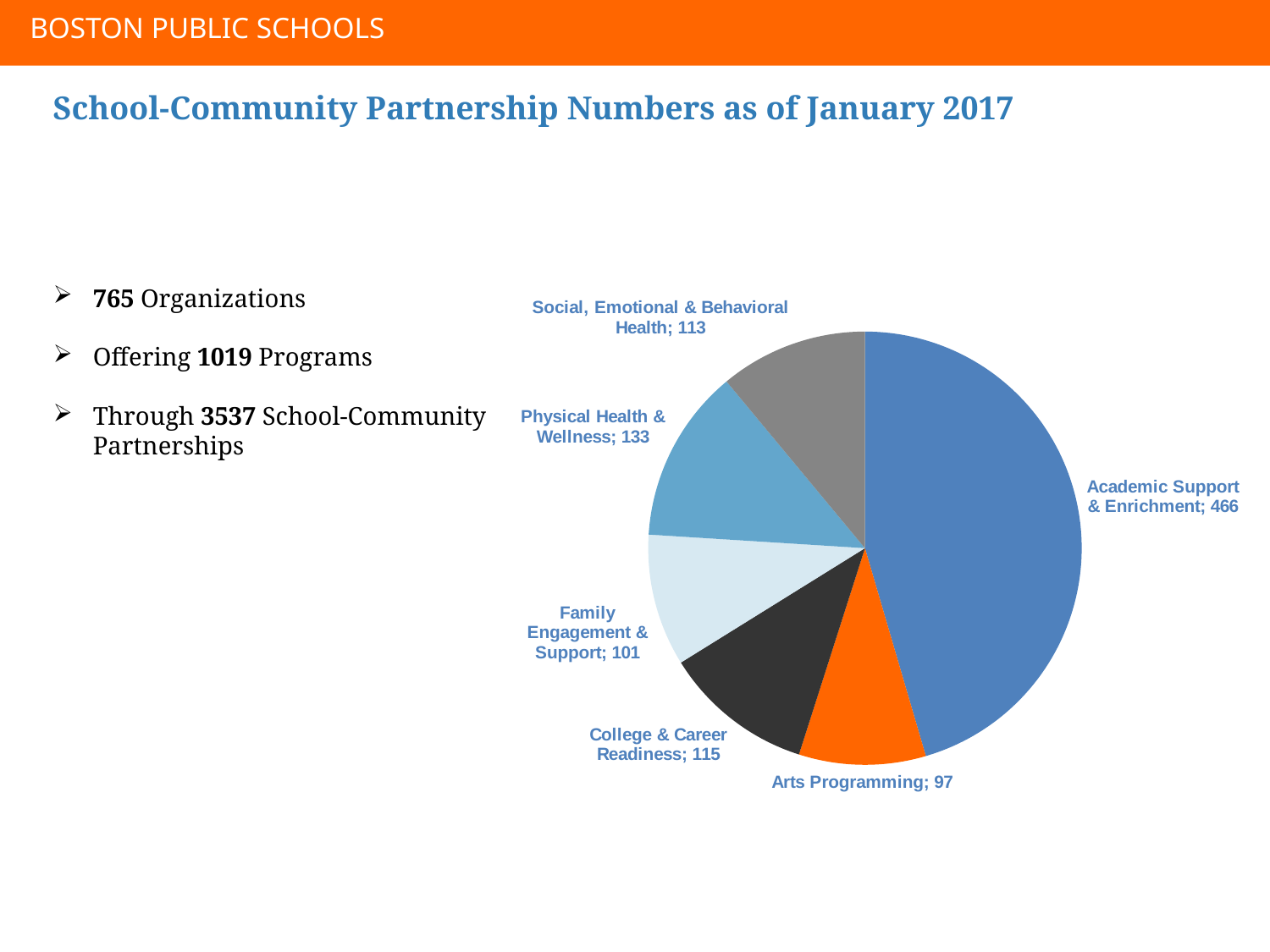
Which category has the largest slice of the pie? Academic Support & Enrichment What is the value for Physical Health & Wellness? 133 What colour is the Arts Programming slice? Orange Which is larger, College & Career Readiness or Social, Emotional & Behavioral Health? College & Career Readiness What is the value for Family Engagement & Support? 101 What type of chart is shown on the slide? Pie chart What is the value for Academic Support & Enrichment? 466 How many slices does the pie chart have? 6 What is the total of all the values shown in the pie chart? 1025 Which category has the smallest slice of the pie? Arts Programming What is the value for Arts Programming? 97 What is the difference between Academic Support & Enrichment and Physical Health & Wellness? 333